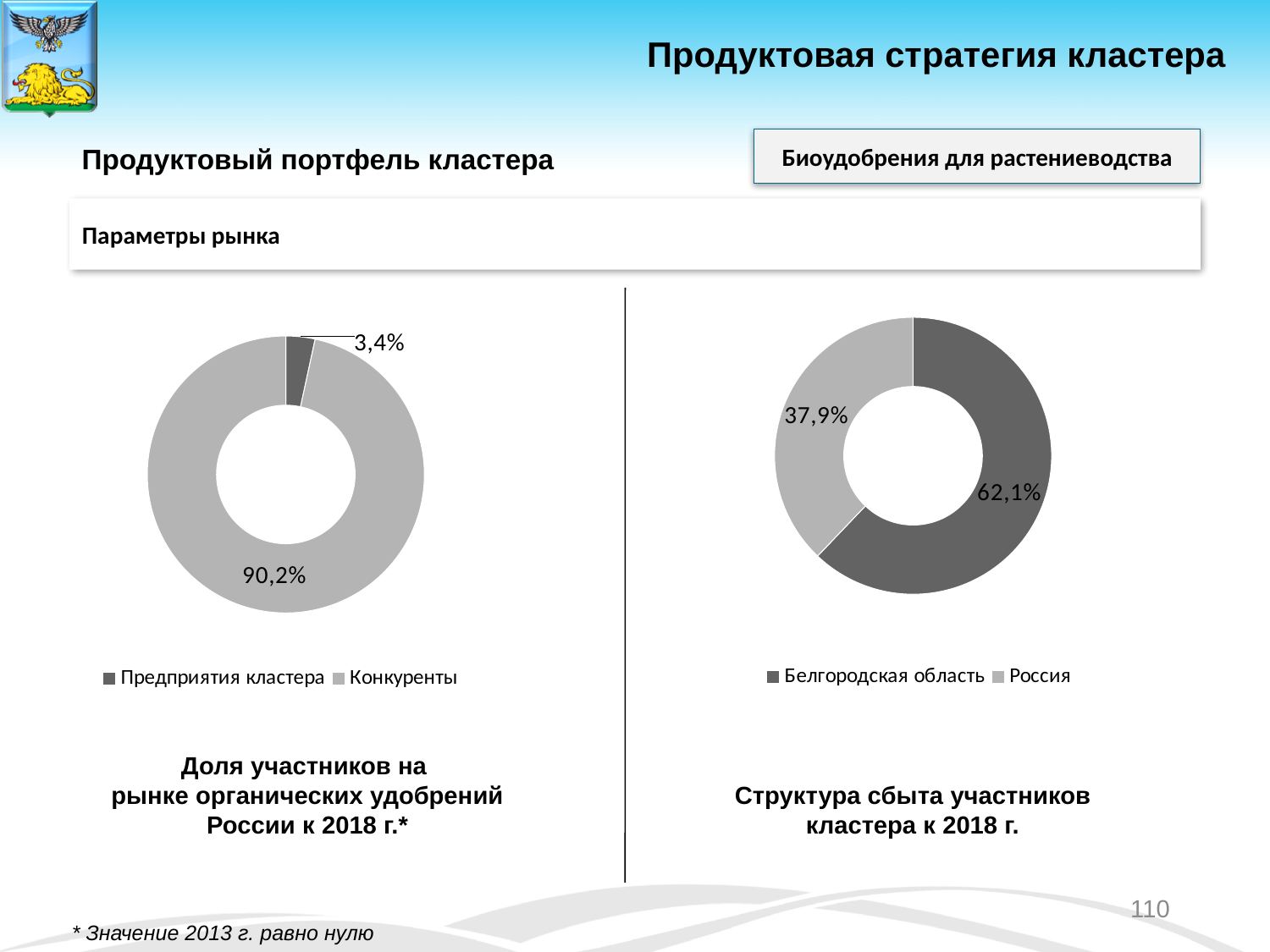
In the left chart (Доля участников на рынке органических удобрений России к 2018 г.), which category has the smallest share? Предприятия кластера In the left chart (Доля участников на рынке органических удобрений России к 2018 г.), what is the value for Конкуренты? 90,2% In the left chart (Доля участников на рынке органических удобрений России к 2018 г.), what is the value for Предприятия кластера? 3,4% In the left chart (Доля участников на рынке органических удобрений России к 2018 г.), which is larger: Предприятия кластера or Конкуренты? Конкуренты What are the legend entries of the right chart (Структура сбыта участников кластера к 2018 г.)? Белгородская область, Россия In the right chart (Структура сбыта участников кластера к 2018 г.), what is the difference between the shares of Белгородская область and Россия? 24,2% What type of chart is the right chart (Структура сбыта участников кластера к 2018 г.)? Doughnut chart In the right chart (Структура сбыта участников кластера к 2018 г.), which category has the largest share? Белгородская область What is the title of the left chart on the slide? Доля участников на рынке органических удобрений России к 2018 г.* In the right chart (Структура сбыта участников кластера к 2018 г.), what is the value for Россия? 37,9% How many categories does the legend of the left chart (Доля участников на рынке органических удобрений России к 2018 г.) list? 2 In the right chart (Структура сбыта участников кластера к 2018 г.), what is the value for Белгородская область? 62,1%